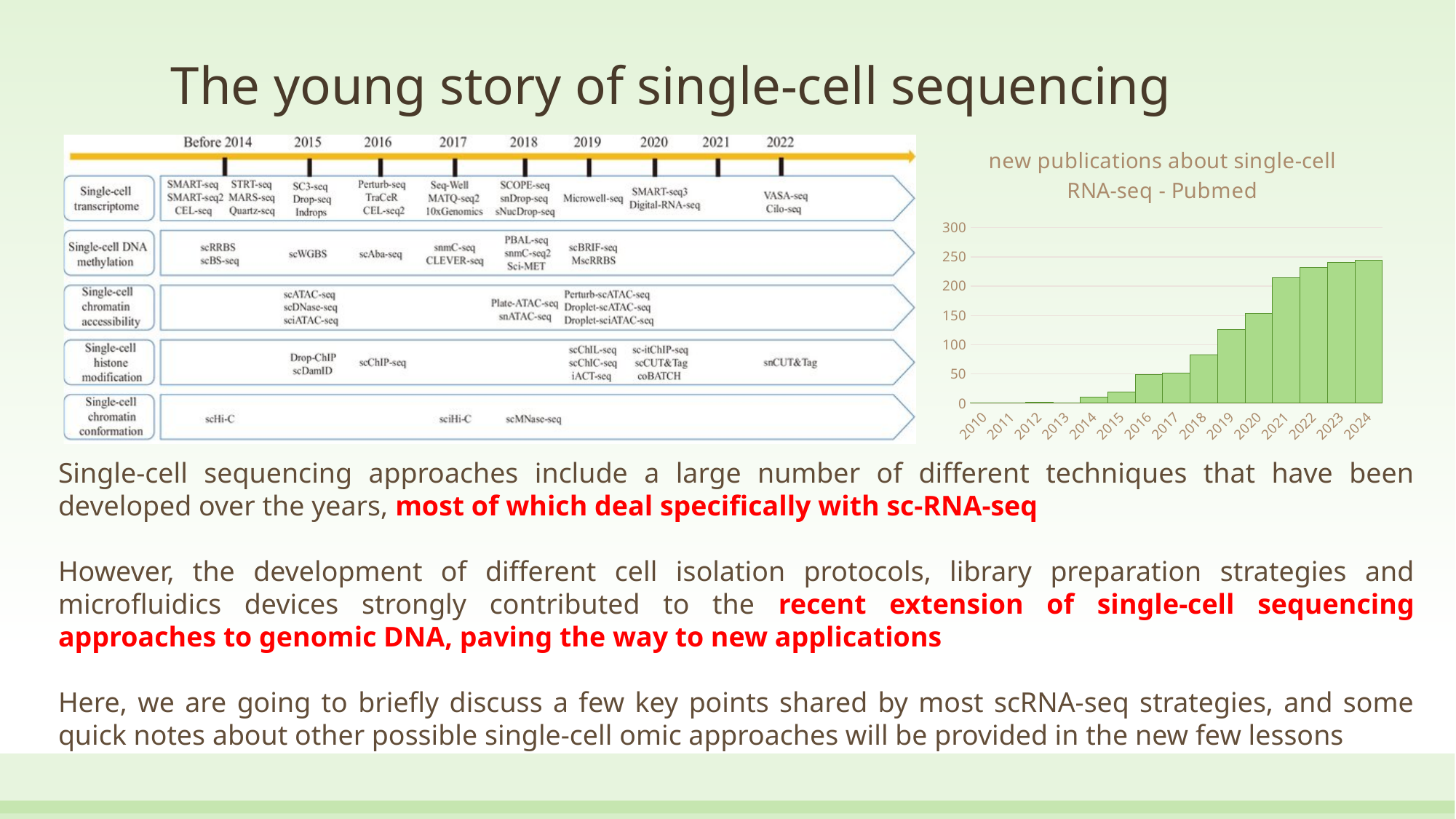
Is the value for 2021 in the publications chart greater or less than 200? greater What is the title of the chart on the right of the slide? new publications about single-cell RNA-seq - Pubmed Do the values in the publications chart generally rise or fall from 2010 to 2024? rise What kind of chart is shown on the right of the slide? bar chart Is the value for 2019 in the publications chart greater or less than 100? greater What is the highest value shown on the y axis of the publications chart? 300 How many years are shown on the x axis of the publications chart? 15 Which year has more new publications in the chart, 2020 or 2016? 2020 Which year has more new publications in the chart, 2014 or 2018? 2018 Is the value for 2015 in the publications chart greater or less than 50? less Which year has the highest number of new publications in the chart? 2024